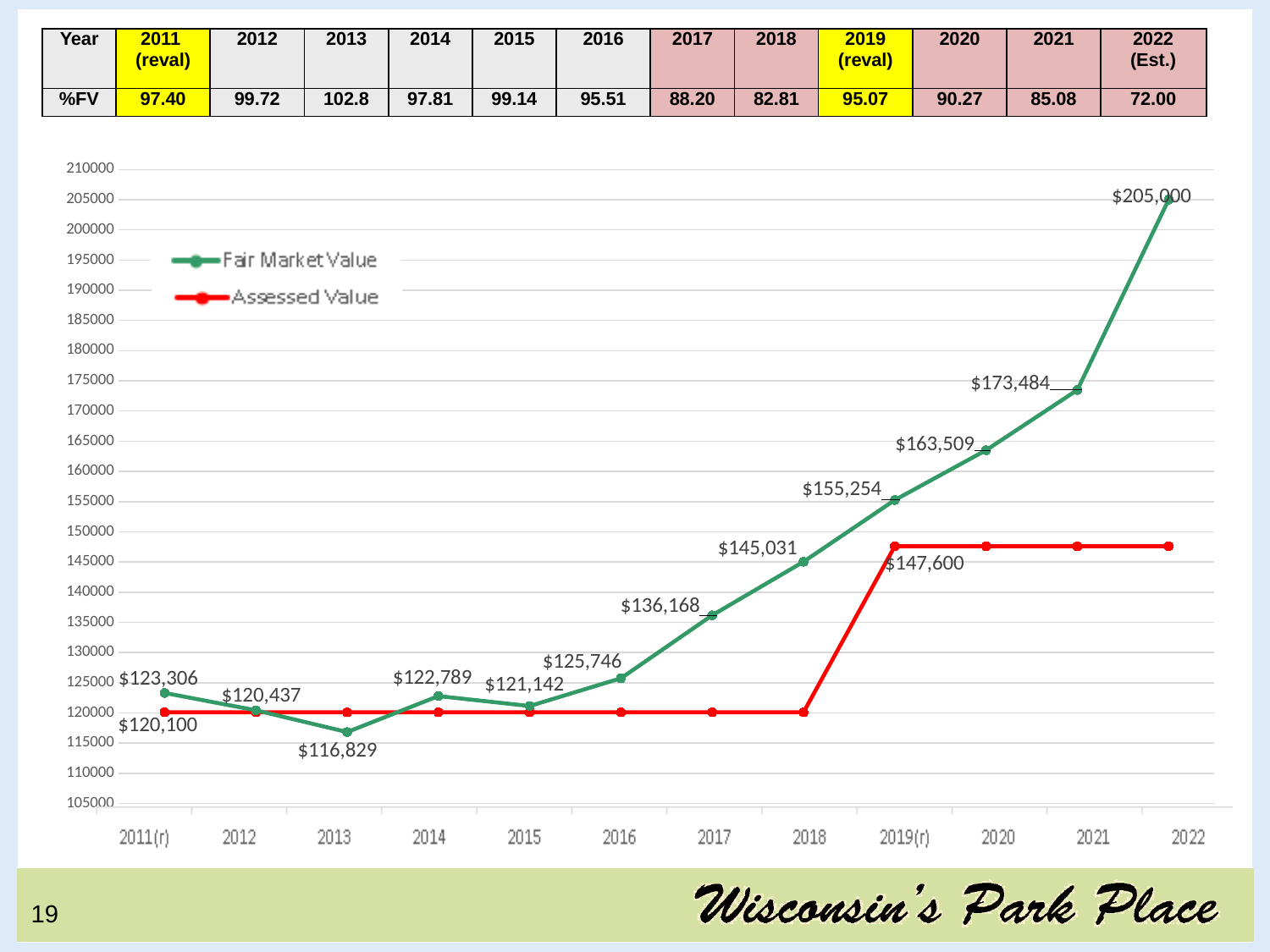
What is the Fair Market Value for 2022? $205,000 What is the difference between the Fair Market Value in 2022 and in 2021? $31,516 Is the Assessed Value for 2021 greater or less than 150000? less How many years are shown on the x axis of the chart? 12 What is the Assessed Value for 2019(r)? $147,600 What is the Assessed Value for 2011(r)? $120,100 Which year has the highest Fair Market Value? 2022 Which year has the lowest Fair Market Value? 2013 What is the Fair Market Value for 2017? $136,168 How many series does the chart legend list? 2 What kind of chart is shown on the slide? Line chart Which is larger in 2020, the Fair Market Value or the Assessed Value? Fair Market Value